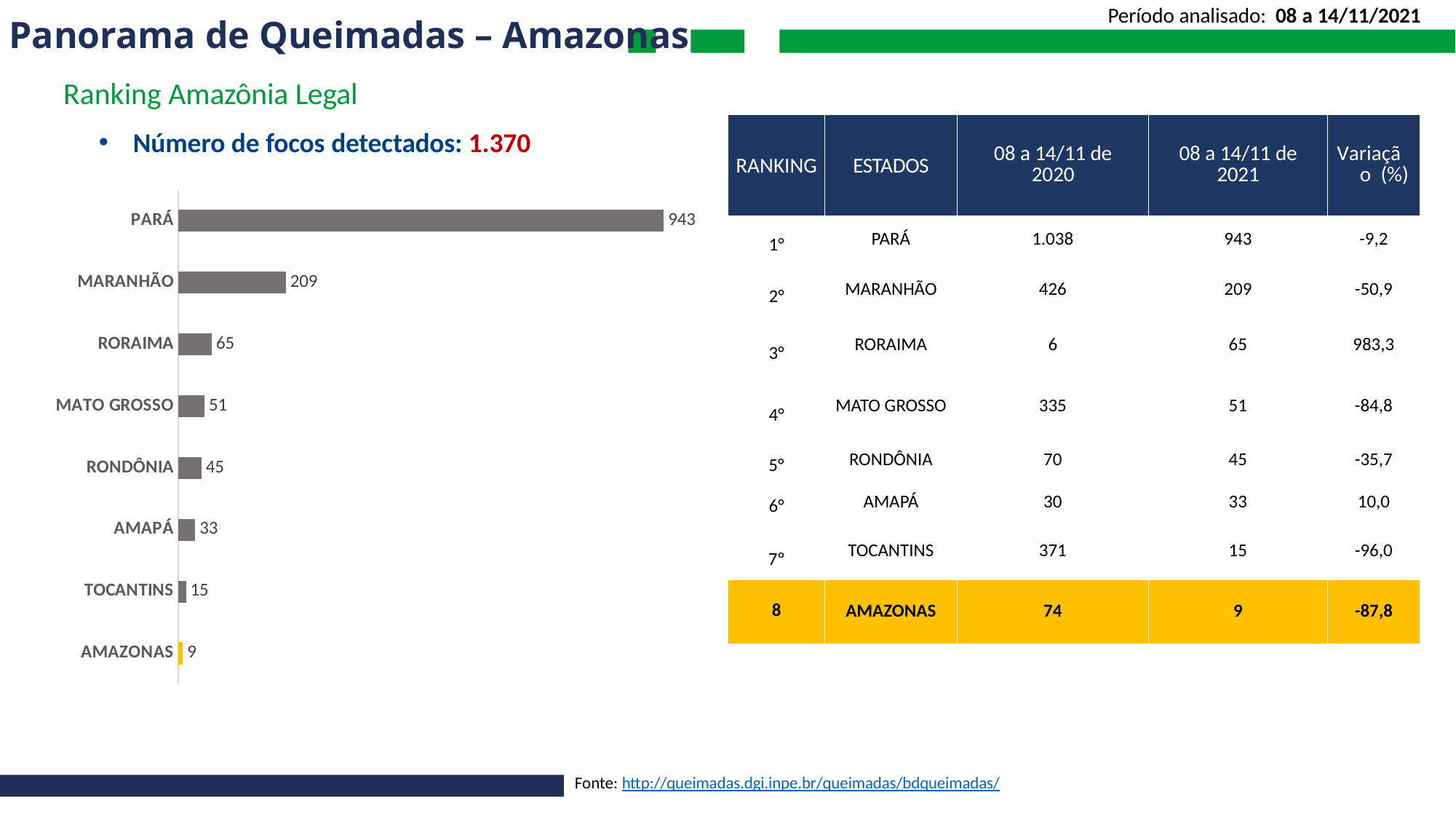
What is the difference between the values for PARÁ and MARANHÃO in the bar chart? 734 What kind of chart is shown on the slide? bar chart What is the value for MARANHÃO in the bar chart? 209 What is the difference between the values for RORAIMA and MATO GROSSO in the bar chart? 14 Which state has the highest value in the bar chart? PARÁ What is the value for TOCANTINS in the bar chart? 15 How many states are shown in the bar chart? 8 What is the value for AMAZONAS in the bar chart? 9 Which state has the lowest value in the bar chart? AMAZONAS Which bar in the chart is coloured yellow rather than grey? AMAZONAS Which has a larger value in the bar chart, RONDÔNIA or AMAPÁ? RONDÔNIA What is the value for PARÁ in the bar chart? 943